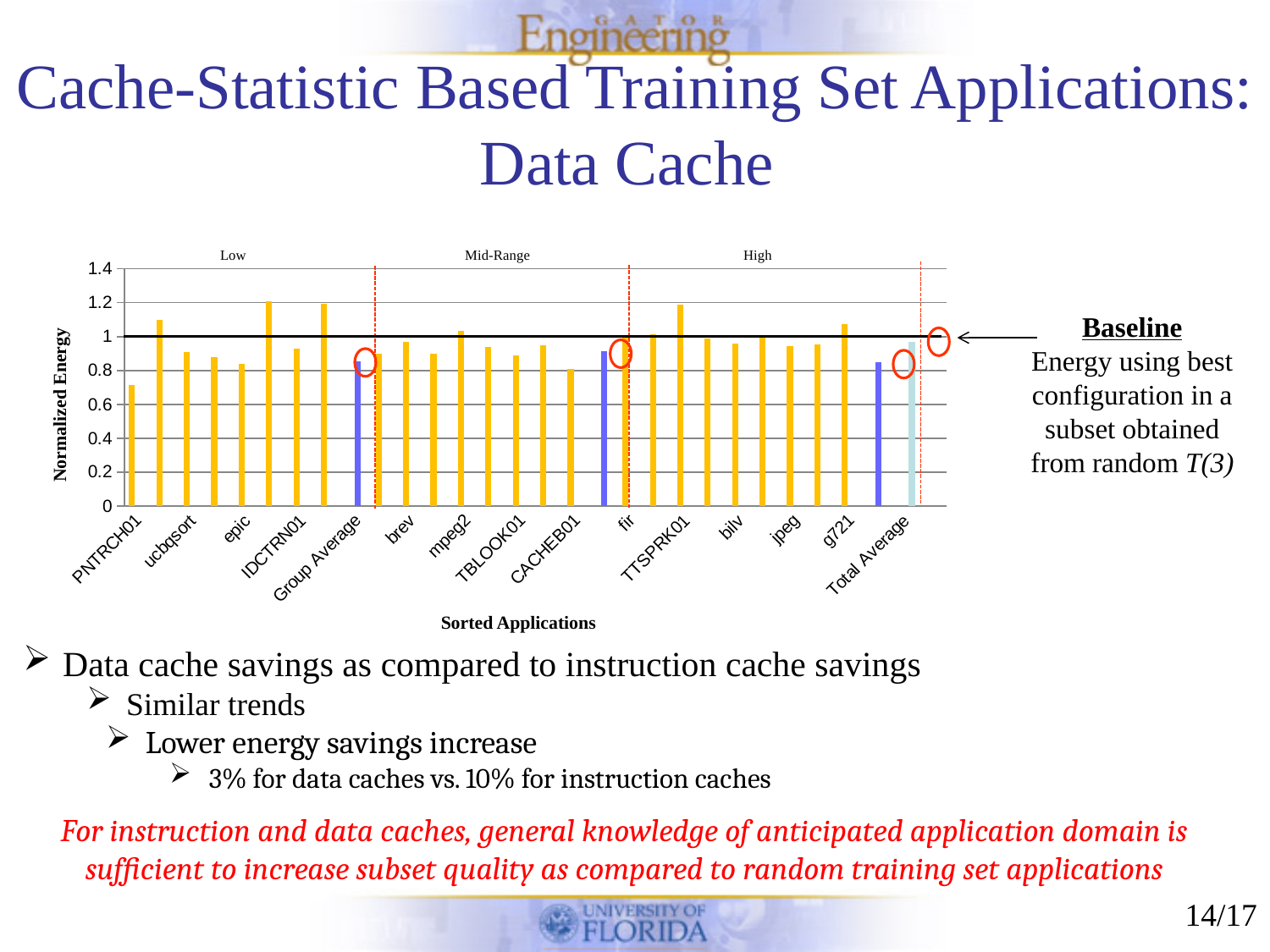
Is the value for Group Average in the Low group greater or less than 1? less At what value on the vertical axis is the Baseline line drawn? 1 Which is larger, the value for PNTRCH01 or the Group Average of the Low group? Group Average What is the title of the horizontal axis of the chart? Sorted Applications What kind of chart is shown on the slide? bar chart Do the values rise steadily, fall steadily, or fluctuate across the applications along the x axis? fluctuate Is the value for PNTRCH01 greater or less than 0.8? less What is the title of the vertical axis of the chart? Normalized Energy What is the maximum value shown on the vertical axis? 1.4 Which is larger, the value for PNTRCH01 or the value for ucbqsort? ucbqsort How many application groups (Low, Mid-Range, High) are marked on the chart? 3